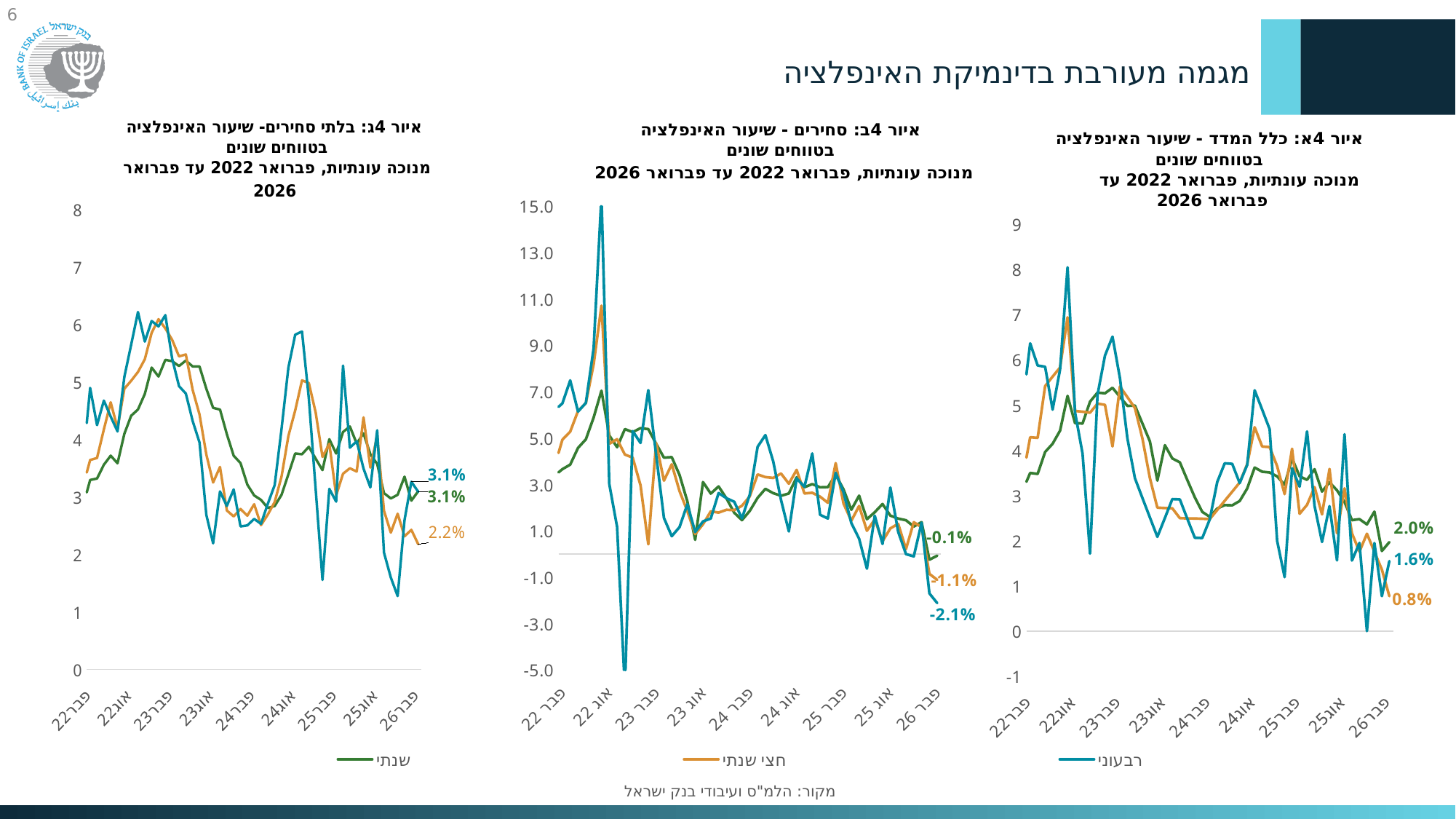
How many series does the legend at the bottom of the slide list? 3 In the chart titled 'איור 4ב: סחירים', what is the final labelled value of the green (שנתי) series? -0.1% In the chart titled 'איור 4א: כלל המדד', what is the final labelled value of the green (שנתי) series? 2.0% In the chart titled 'איור 4א: כלל המדד', what is the final labelled value of the blue (רבעוני) series? 1.6% In the chart titled 'איור 4ב: סחירים', is the peak of the blue (רבעוני) series around אוג 22 greater or less than 13.0? greater In the chart titled 'איור 4א: כלל המדד', what is the final labelled value of the orange (חצי שנתי) series? 0.8% In the chart titled 'איור 4ג: בלתי סחירים', what is the final labelled value of the orange (חצי שנתי) series? 2.2% What kind of chart is used in the three charts on this slide? Line chart In the chart titled 'איור 4א: כלל המדד', what is the difference between the final labelled values of the green (שנתי) series and the orange (חצי שנתי) series? 1.2 percentage points In the chart titled 'איור 4ב: סחירים', which series ends lower, the blue (רבעוני) series at -2.1% or the orange (חצי שנתי) series at -1.1%? The blue (רבעוני) series In the chart titled 'איור 4ב: סחירים', what is the final labelled value of the blue (רבעוני) series? -2.1% In the chart titled 'איור 4ג: בלתי סחירים', what is the final labelled value of the green (שנתי) series? 3.1%